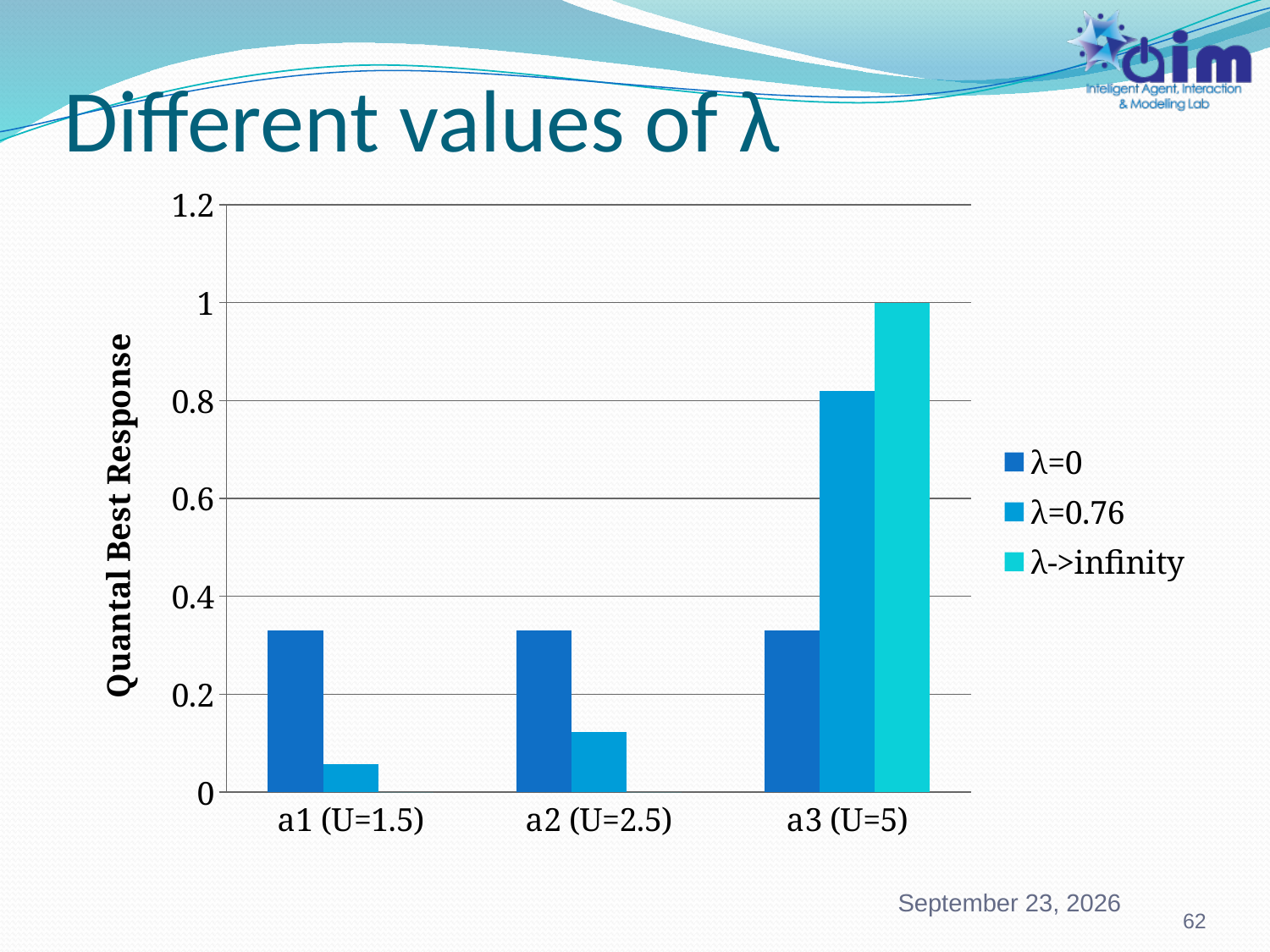
Is the value for λ=0.76 at a3 (U=5) greater or less than 0.6? greater Do the values for the λ=0.76 series rise or fall from a1 (U=1.5) to a3 (U=5)? rise Is the value for λ=0 at a1 (U=1.5) greater or less than 0.4? less How many series does the chart's legend list? 3 Is the value for λ=0.76 at a1 (U=1.5) greater or less than 0.2? less What is the title of the chart's vertical axis? Quantal Best Response Which category has the lowest value for the λ=0.76 series? a1 (U=1.5) What kind of chart is shown on the slide? bar chart At a3 (U=5), which is larger: the value for λ=0 or the value for λ=0.76? λ=0.76 What is the Quantal Best Response for λ->infinity at a3 (U=5)? 1 How many categories are shown on the x axis of the chart? 3 Which category has the highest value for the λ=0.76 series? a3 (U=5)